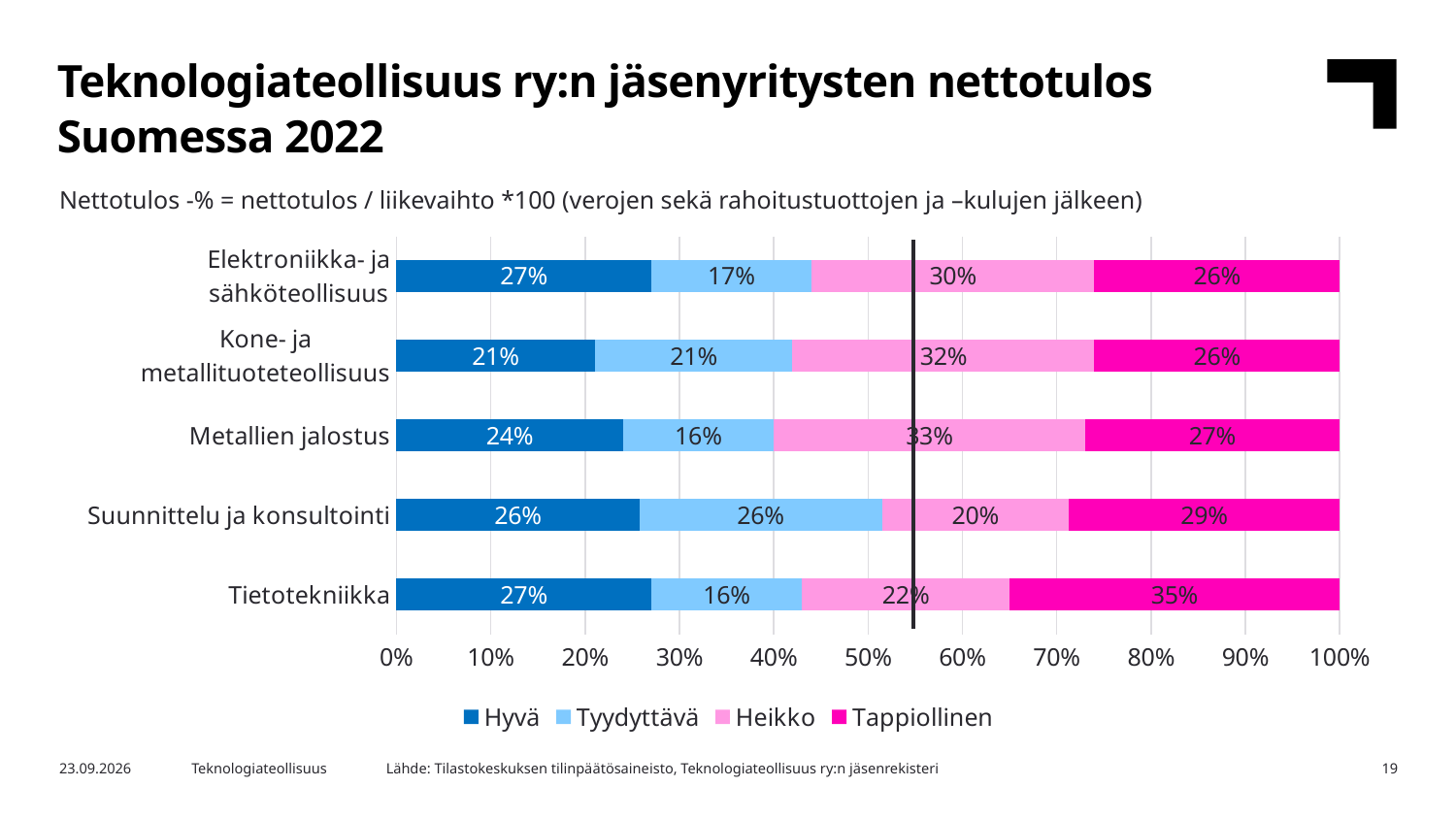
Which category has the highest Tappiollinen share? Tietotekniikka What is the Tappiollinen share for Tietotekniikka? 35% How many series does the legend list? 4 What is the Hyvä share for Kone- ja metallituoteteollisuus? 21% How many industry categories are shown in the chart? 5 Which series is shown in the darkest blue colour in the legend? Hyvä What is the difference between the Heikko share of Kone- ja metallituoteteollisuus and that of Tietotekniikka? 10 percentage points Which is larger: the Hyvä share for Metallien jalostus or the Hyvä share for Elektroniikka- ja sähköteollisuus? Elektroniikka- ja sähköteollisuus Which category has the lowest Heikko share? Suunnittelu ja konsultointi What is the Heikko share for Metallien jalostus? 33% What is the Tyydyttävä share for Suunnittelu ja konsultointi? 26% What kind of chart is shown on the slide? Stacked bar chart